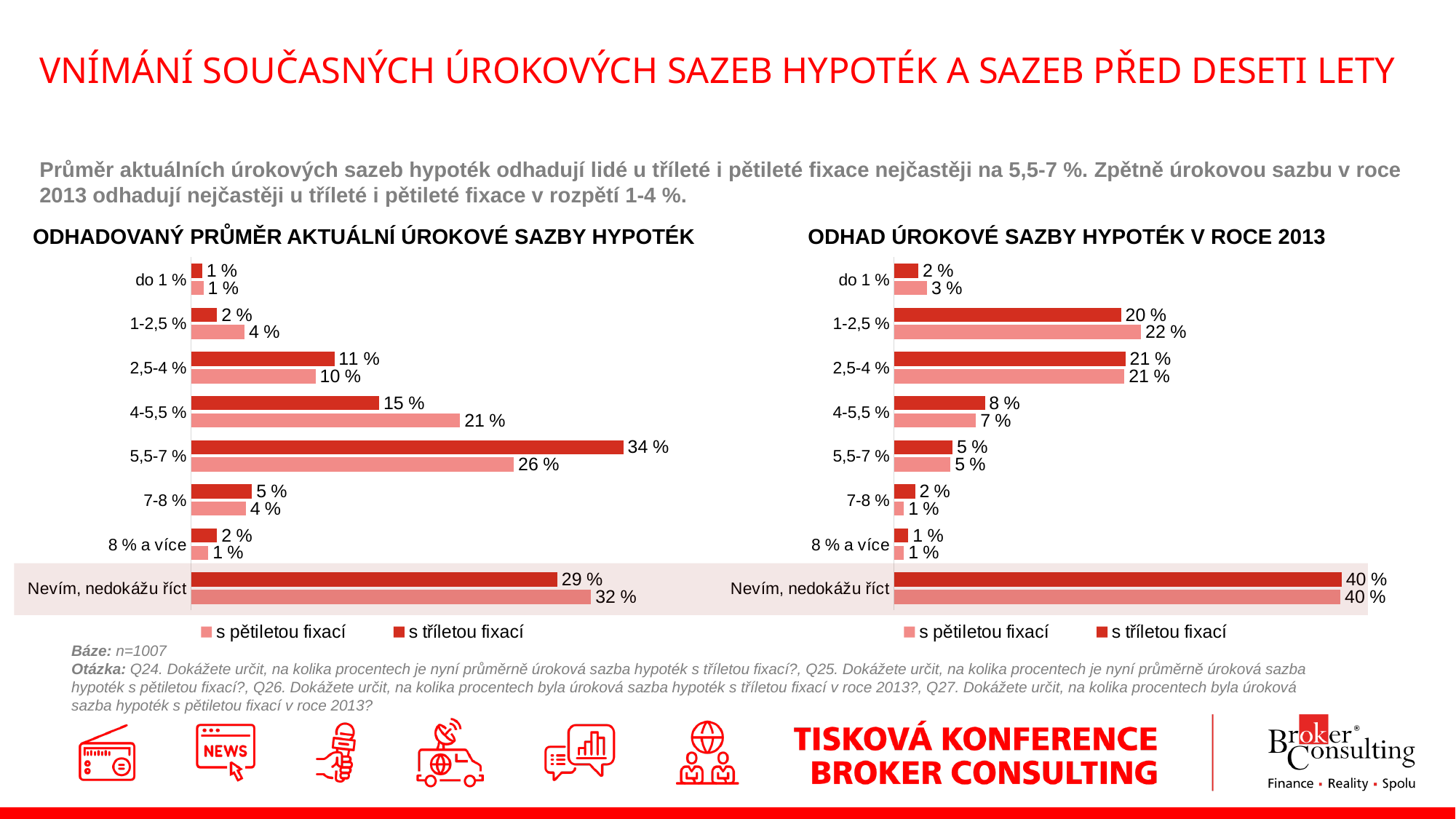
What type of chart is the right chart (ODHAD ÚROKOVÉ SAZBY HYPOTÉK V ROCE 2013)? Bar chart In the right chart (ODHAD ÚROKOVÉ SAZBY HYPOTÉK V ROCE 2013), what is the difference between the 's pětiletou fixací' value for 1-2,5 % and the 's tříletou fixací' value for 4-5,5 %? 14 % In the right chart (ODHAD ÚROKOVÉ SAZBY HYPOTÉK V ROCE 2013), what is the value for 1-2,5 % in the series 's pětiletou fixací'? 22 % In the left chart (ODHADOVANÝ PRŮMĚR AKTUÁLNÍ ÚROKOVÉ SAZBY HYPOTÉK), what is the difference between the 's tříletou fixací' and 's pětiletou fixací' values for 5,5-7 %? 8 % In the left chart (ODHADOVANÝ PRŮMĚR AKTUÁLNÍ ÚROKOVÉ SAZBY HYPOTÉK), what is the value for 4-5,5 % in the series 's pětiletou fixací'? 21 % How many categories are shown on the y axis of the right chart (ODHAD ÚROKOVÉ SAZBY HYPOTÉK V ROCE 2013)? 8 In the left chart (ODHADOVANÝ PRŮMĚR AKTUÁLNÍ ÚROKOVÉ SAZBY HYPOTÉK), which category has the highest value in the series 's tříletou fixací'? 5,5-7 % In the left chart (ODHADOVANÝ PRŮMĚR AKTUÁLNÍ ÚROKOVÉ SAZBY HYPOTÉK), which is larger for 4-5,5 %: the 's tříletou fixací' value or the 's pětiletou fixací' value? s pětiletou fixací In the right chart (ODHAD ÚROKOVÉ SAZBY HYPOTÉK V ROCE 2013), what is the value for 'Nevím, nedokážu říct' in the series 's tříletou fixací'? 40 % How many series does the legend of the left chart (ODHADOVANÝ PRŮMĚR AKTUÁLNÍ ÚROKOVÉ SAZBY HYPOTÉK) list? 2 In the left chart (ODHADOVANÝ PRŮMĚR AKTUÁLNÍ ÚROKOVÉ SAZBY HYPOTÉK), what is the value for 5,5-7 % in the series 's tříletou fixací'? 34 % In the right chart (ODHAD ÚROKOVÉ SAZBY HYPOTÉK V ROCE 2013), which category has the highest value in the series 's pětiletou fixací'? Nevím, nedokážu říct